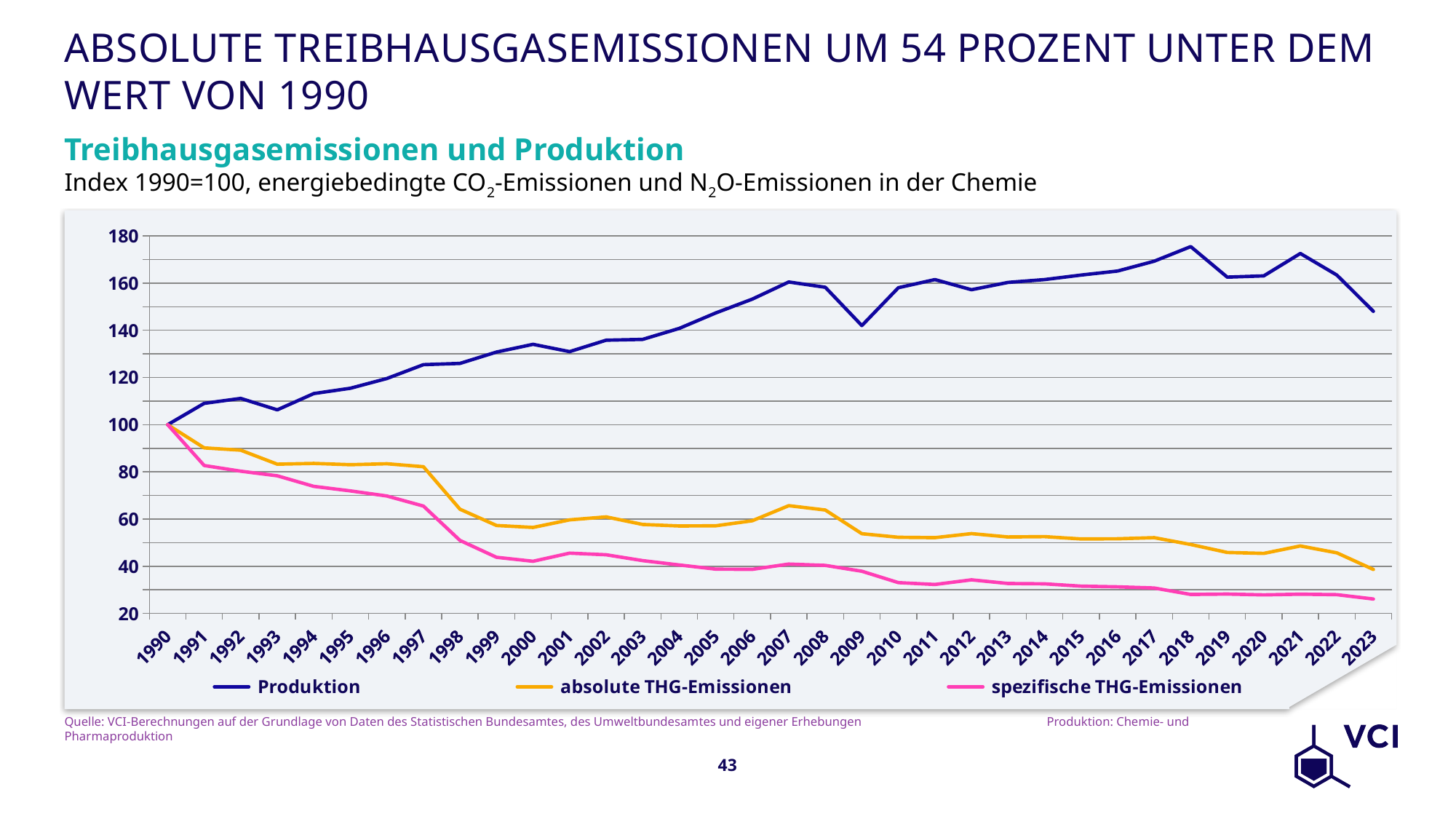
Is the value for Produktion in 2018 greater or less than 160? greater Which series is drawn in orange? absolute THG-Emissionen How many series does the legend list? 3 How many years are plotted along the x axis? 34 What is the index value of Produktion in 1990? 100 In 2023, which is larger: Produktion or absolute THG-Emissionen? Produktion What kind of chart is shown on the slide? line chart In which year does the Produktion line reach its highest value? 2018 In which year is the spezifische THG-Emissionen line at its lowest? 2023 Does the spezifische THG-Emissionen line generally rise or fall from 1990 to 2023? fall Is the value for spezifische THG-Emissionen in 2023 greater or less than 40? less Is the value for absolute THG-Emissionen in 2007 greater or less than 60? greater